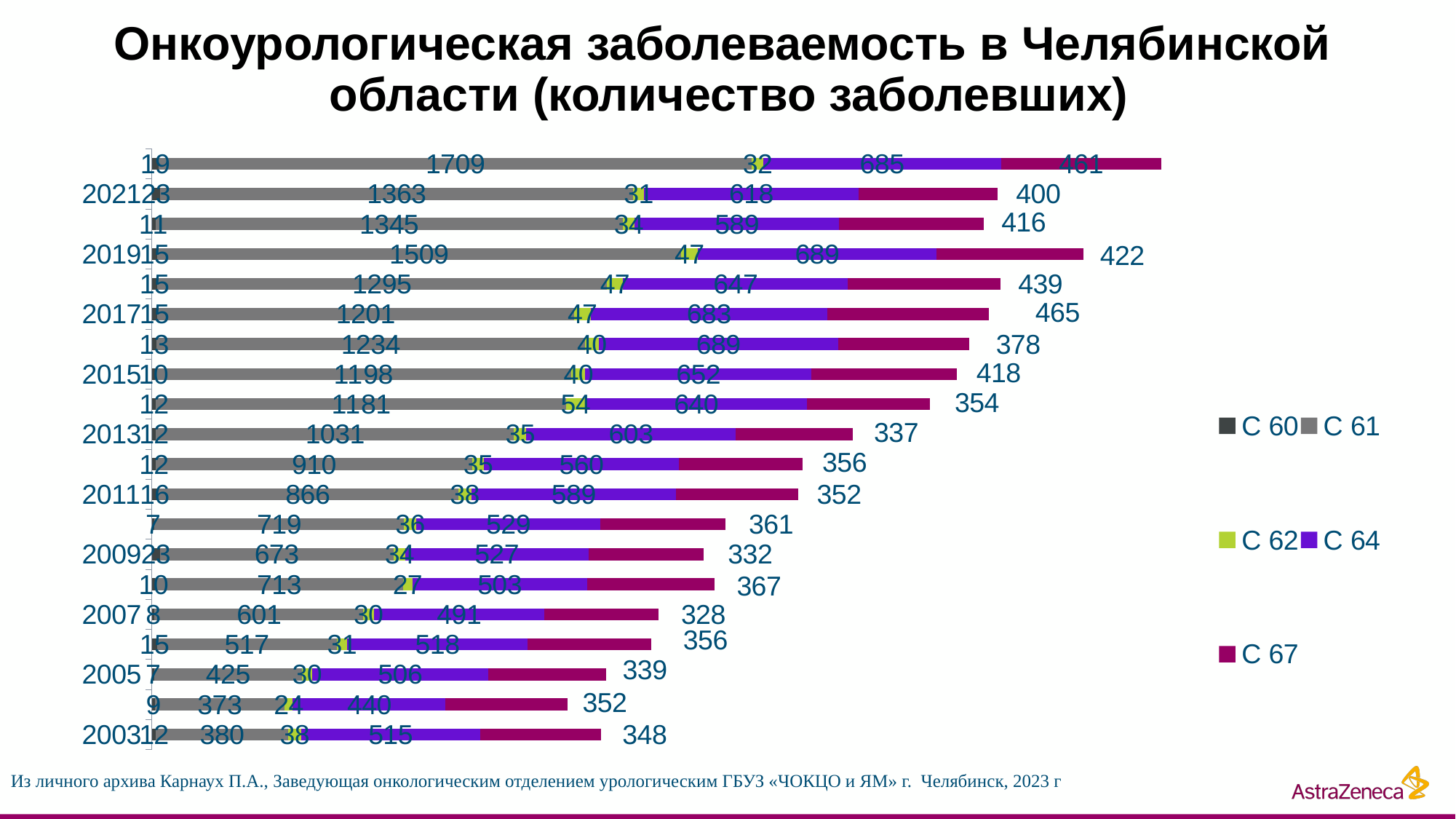
How many series does the legend list? 5 What is the C 61 value for 2019? 1509 What is the difference between the C 67 value for 2017 and the C 67 value for 2015? 47 What is the C 67 value for 2017? 465 How many bars (years) are plotted in the chart? 20 What is the C 67 value for 2021? 400 What is the total of the stacked bar for 2005? 1307 What is the C 64 value for 2003? 515 What is the C 61 value for 2005? 425 Among the years labeled on the axis, which has the highest C 61 value? 2019 What kind of chart is shown on the slide? bar chart Which is larger, the C 64 value for 2011 or the C 64 value for 2013? 2013